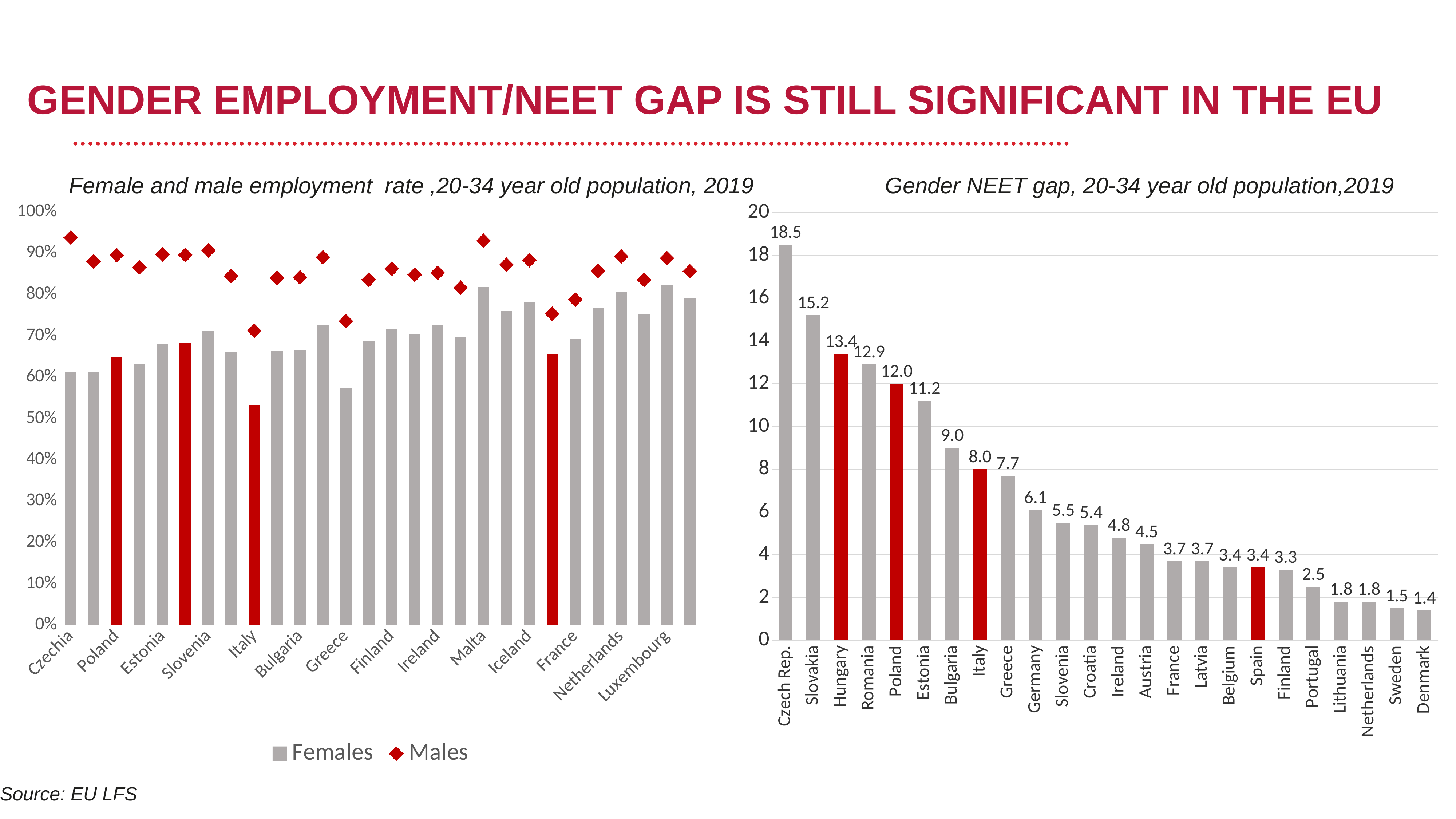
In the Female and male employment rate chart, is the Females value for Italy greater or less than 60%? less In the Gender NEET gap chart, which country has the highest gender NEET gap? Czech Rep. In the Gender NEET gap chart, what is the difference between the values for Czech Rep. and Slovakia? 3.3 In the Gender NEET gap chart, which country has the lowest gender NEET gap? Denmark In the Female and male employment rate chart, how many series does the legend list? 2 In the Female and male employment rate chart, is the Males value for Czechia greater or less than 90%? greater What kind of chart is the Gender NEET gap chart on the right? bar chart In the Gender NEET gap chart, what is the value for Hungary? 13.4 In the Gender NEET gap chart, which has a larger value, Poland or Estonia? Poland In the Gender NEET gap chart, do the values rise or fall from left to right? fall In the Gender NEET gap chart, how many countries are shown? 24 In the Gender NEET gap chart, what is the value for Italy? 8.0